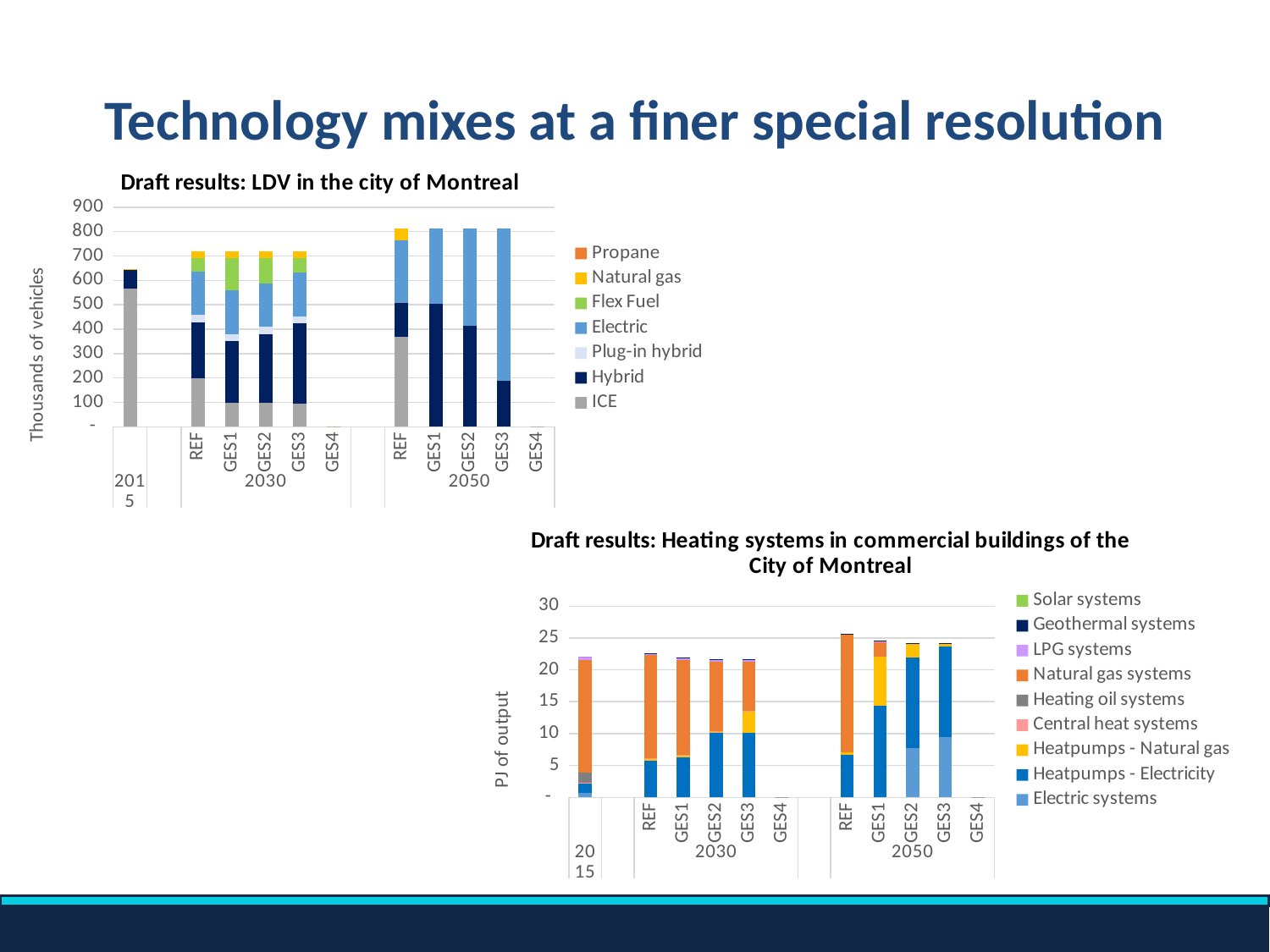
In the 'Draft results: LDV in the city of Montreal' chart, is the total for GES1 in 2050 greater or less than 700? greater In the 'Draft results: Heating systems in commercial buildings of the City of Montreal' chart, is the total for REF in 2050 greater or less than 20? greater In the 'Draft results: LDV in the city of Montreal' chart, how many bar categories are shown along the x axis? 11 What type of chart is 'Draft results: LDV in the city of Montreal'? Stacked bar chart How many series does the legend of the 'Draft results: LDV in the city of Montreal' chart list? 7 How many series does the legend of the 'Draft results: Heating systems in commercial buildings of the City of Montreal' chart list? 9 In the 'Draft results: LDV in the city of Montreal' chart, which has the larger total, REF in 2030 or REF in 2050? REF in 2050 In the 'Draft results: Heating systems in commercial buildings of the City of Montreal' chart, which category has the highest total? REF in 2050 What is the y-axis label of the 'Draft results: Heating systems in commercial buildings of the City of Montreal' chart? PJ of output In the 'Draft results: Heating systems in commercial buildings of the City of Montreal' chart, which has the larger total, REF in 2030 or REF in 2050? REF in 2050 What is the y-axis label of the 'Draft results: LDV in the city of Montreal' chart? Thousands of vehicles In the 'Draft results: LDV in the city of Montreal' chart, is the total for 2015 greater or less than 500? greater